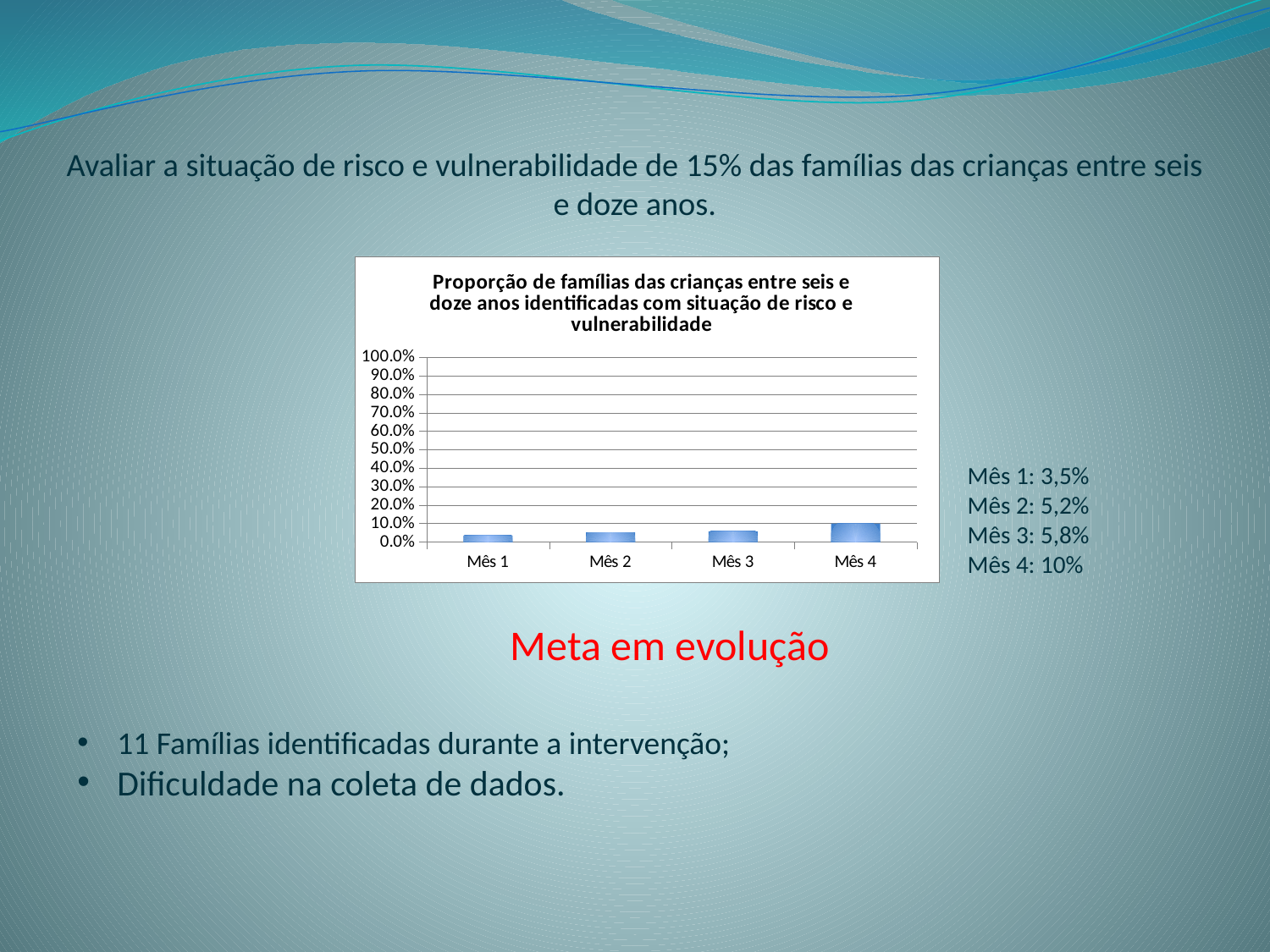
Is the value for Mês 4 greater or less than 20%? less What kind of chart is shown on the slide? bar chart What is the title of the chart? Proporção de famílias das crianças entre seis e doze anos identificadas com situação de risco e vulnerabilidade Which month has the lowest proportion of families identified? Mês 1 How many categories (months) are plotted on the chart? 4 What is the value for Mês 3? 5,8% Which month has the highest proportion of families identified? Mês 4 Do the values rise or fall from Mês 1 to Mês 4? rise What is the value for Mês 2? 5,2% What is the difference between the values for Mês 4 and Mês 1? 6,5% What is the value for Mês 1? 3,5% What is the value for Mês 4? 10%